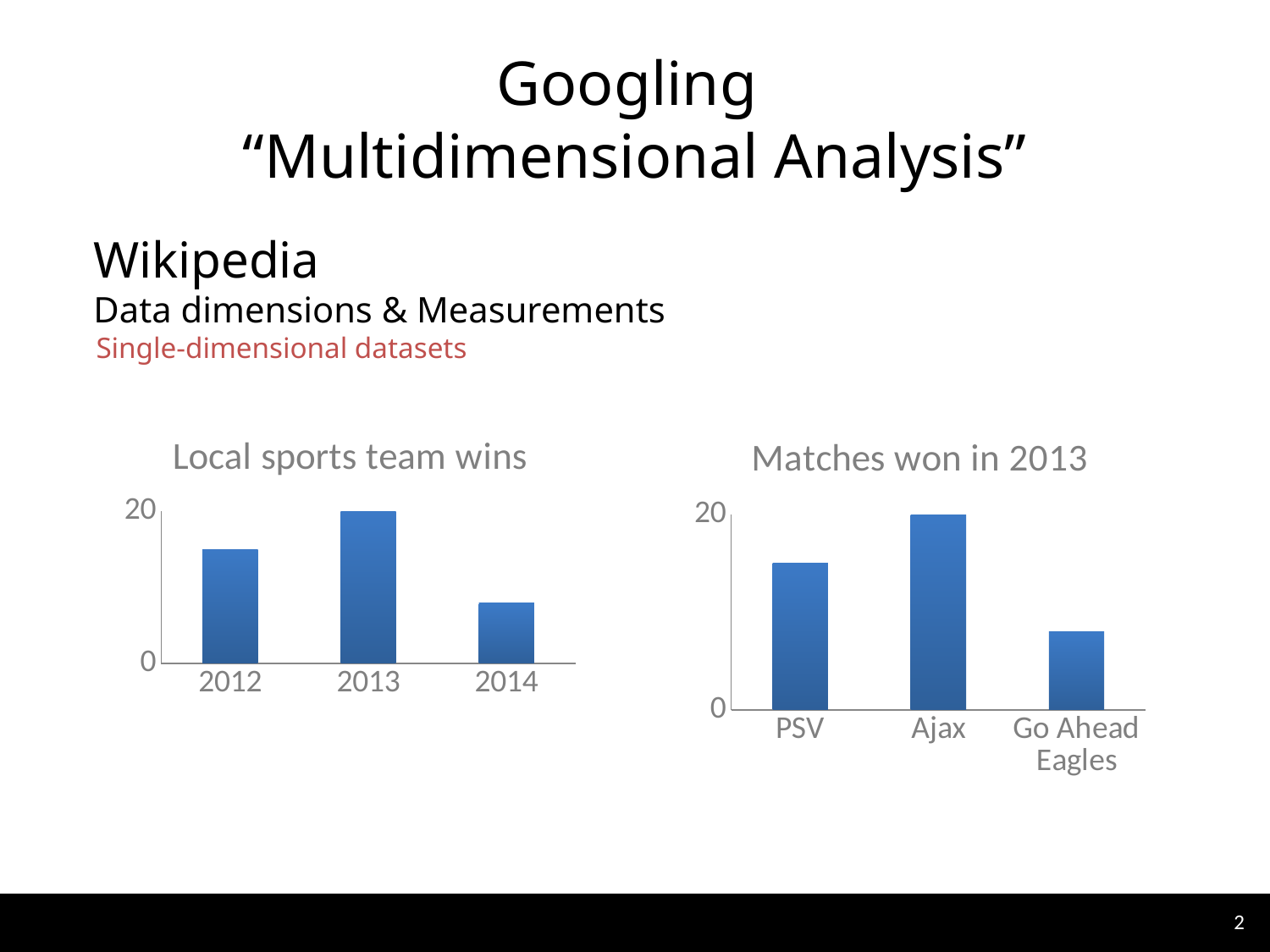
What is the title of the chart on the right side of the slide? Matches won in 2013 In the 'Matches won in 2013' chart, which team won the fewest matches? Go Ahead Eagles In the 'Local sports team wins' chart, which year has the highest number of wins? 2013 What kind of chart is the 'Local sports team wins' chart? bar chart In the 'Local sports team wins' chart, is the value for 2014 greater or less than 20? less In the 'Local sports team wins' chart, how many years are shown on the x axis? 3 In the 'Local sports team wins' chart, which is larger, the value for 2012 or the value for 2014? 2012 What kind of chart is the 'Matches won in 2013' chart? bar chart In the 'Matches won in 2013' chart, is the value for PSV greater or less than 20? less In the 'Matches won in 2013' chart, how many teams are shown? 3 In the 'Local sports team wins' chart, which year has the lowest number of wins? 2014 In the 'Matches won in 2013' chart, which team won the most matches? Ajax